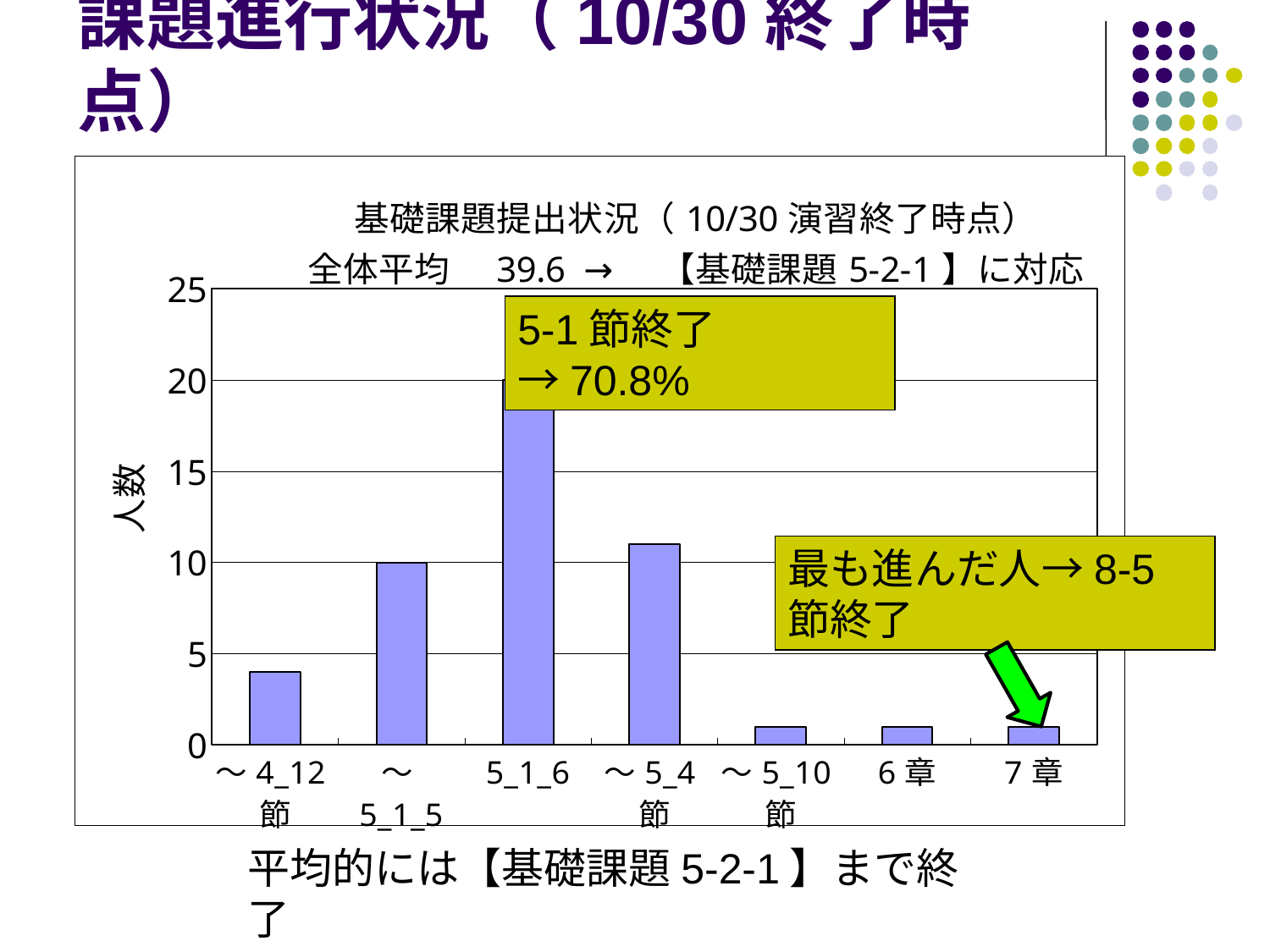
What is the value (人数) for the category ～5_1_5? 10 Is the value for 6章 greater or less than 5? less Which category has the highest bar in the chart? 5_1_6 What is the label on the y axis of the chart? 人数 Which has the larger value, ～4_12節 or ～5_1_5? ～5_1_5 What kind of chart is shown on the slide? bar chart What overall average (全体平均) is stated above the chart? 39.6 Is the value for 5_1_6 greater or less than 15? greater Is the value for ～4_12節 greater or less than 5? less How many categories are shown on the x axis of the chart? 7